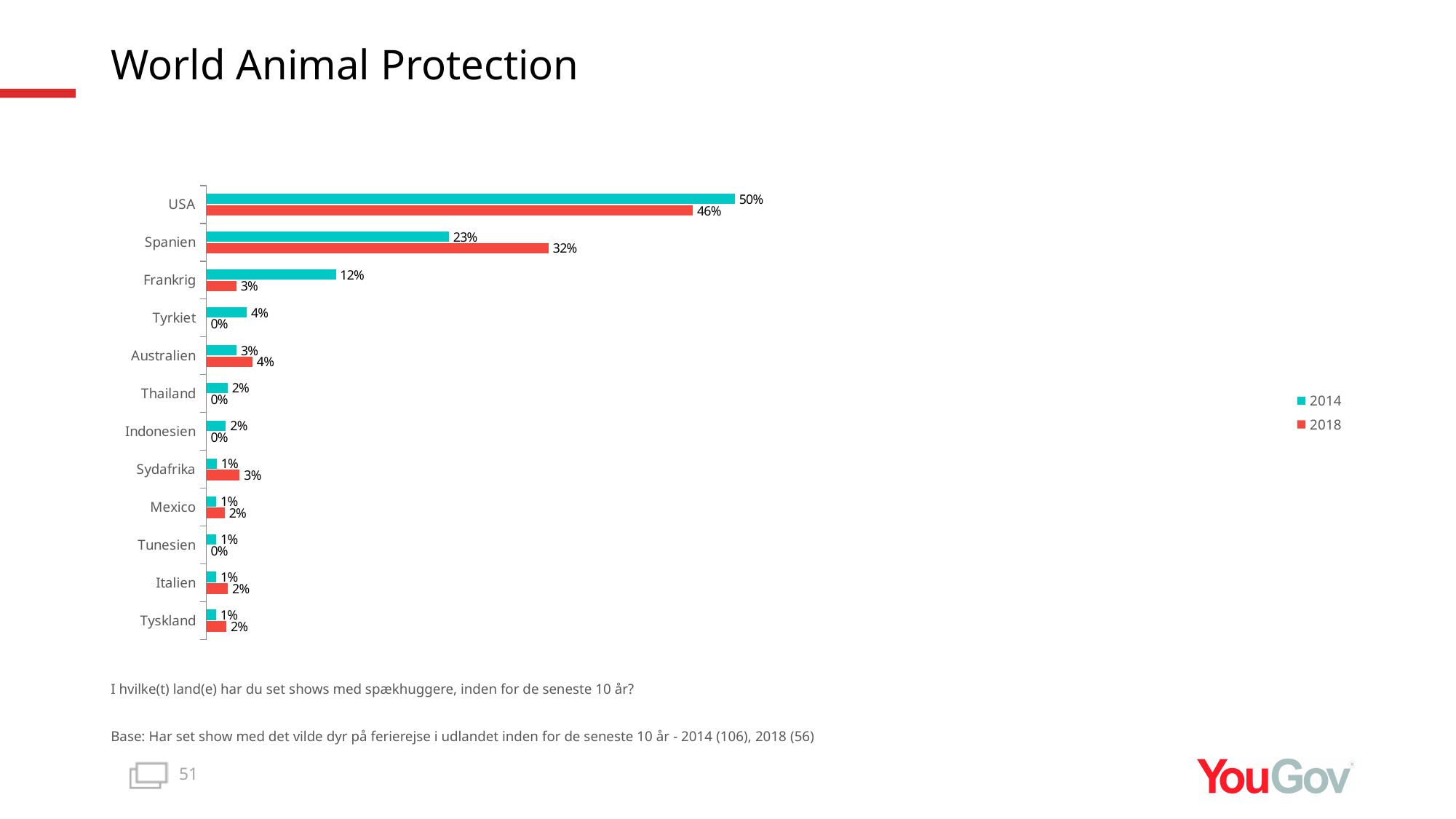
What is the difference between the 2014 and 2018 values for Spanien? 9% For Sydafrika, which year has the larger value, 2014 or 2018? 2018 What is the 2014 value for USA? 50% Which country has the highest 2018 value? USA What kind of chart is shown on the slide? Bar chart What is the 2018 value for Frankrig? 3% What is the 2018 value for Spanien? 32% How many countries are shown on the chart? 12 What is the difference between the 2014 and 2018 values for USA? 4% For Frankrig, which year has the larger value, 2014 or 2018? 2014 How many series does the legend list? 2 Which series is shown in red in the legend? 2018